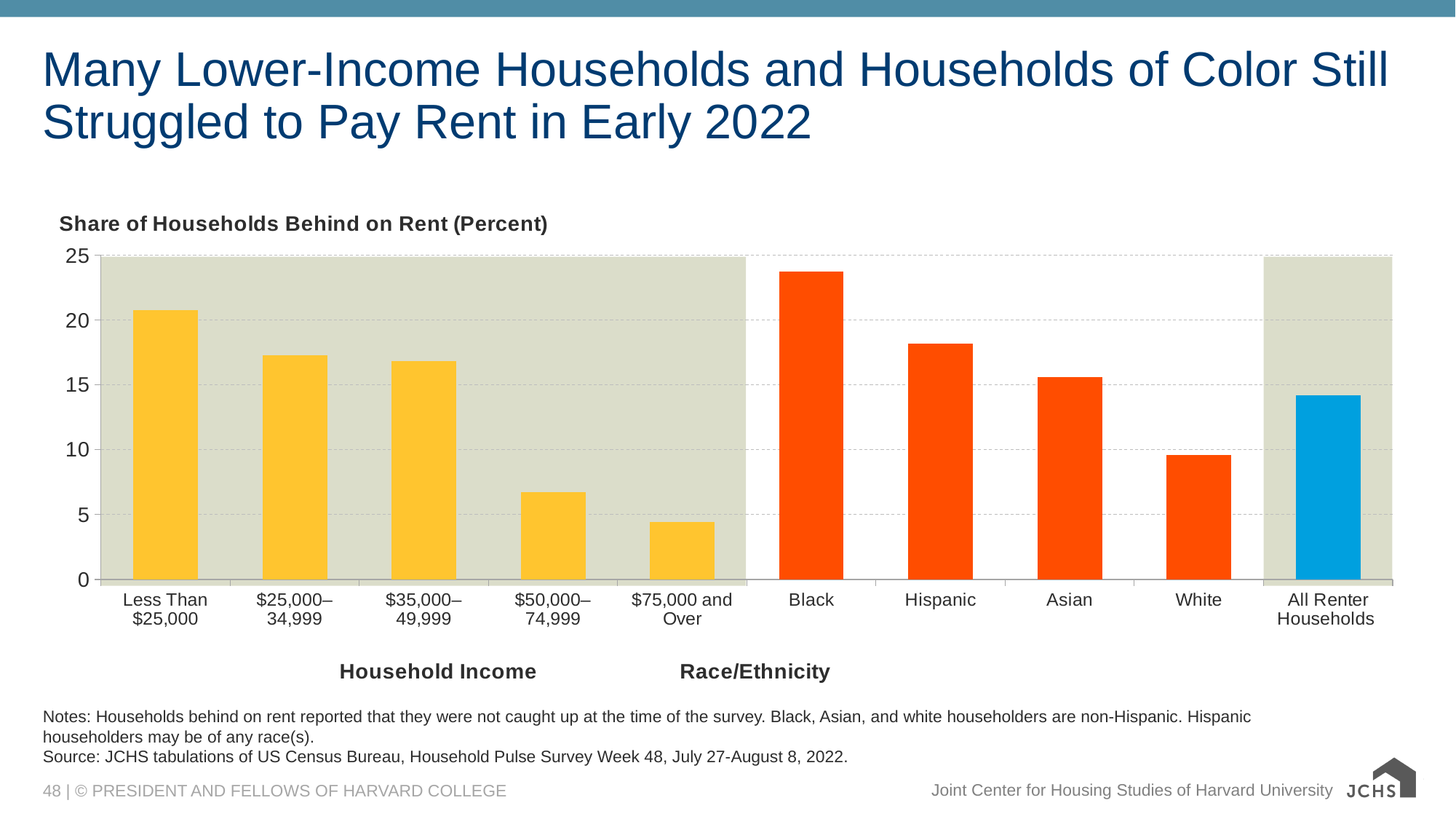
Which category has the highest share of households behind on rent? Black Is the value for $50,000–74,999 greater or less than 5? greater Is the value for Less Than $25,000 greater or less than 20? greater How many bars are plotted in the chart? 10 Is the value for All Renter Households greater or less than 15? less What kind of chart is shown on the slide? bar chart What is the title of the chart's vertical axis measure shown above the chart? Share of Households Behind on Rent (Percent) Which category has the lowest share of households behind on rent? $75,000 and Over Across the Household Income categories from Less Than $25,000 to $75,000 and Over, do the values rise or fall? fall Which is larger, the value for Black or the value for White? Black